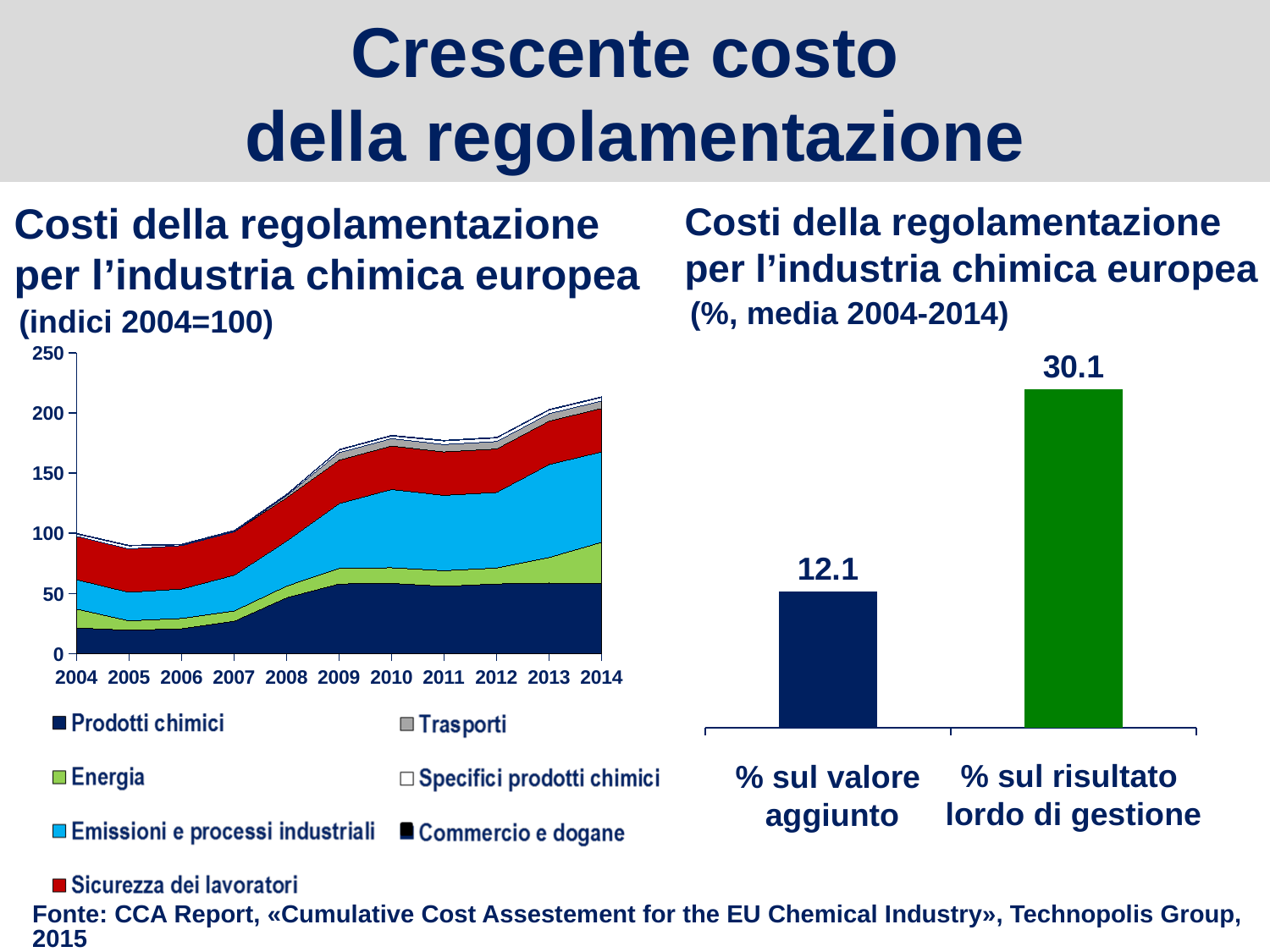
In the left chart (indici 2004=100), is the total value for 2005 greater or less than 100? less In the left chart (indici 2004=100), which series is shown in red? Sicurezza dei lavoratori In the left chart (indici 2004=100), is the total value for 2014 greater or less than 200? greater In the right chart (%, media 2004-2014), how many bars are shown? 2 In the left chart (indici 2004=100), how many years are shown on the x axis? 11 In the left chart (indici 2004=100), how many series does the legend list? 7 In the right chart (%, media 2004-2014), what is the difference between the two bars? 18.0 What kind of chart is the right chart (%, media 2004-2014)? Bar chart In the right chart (%, media 2004-2014), what is the value for '% sul valore aggiunto'? 12.1 In the right chart (%, media 2004-2014), what is the value for '% sul risultato lordo di gestione'? 30.1 In the left chart (indici 2004=100), do the total costs rise or fall between 2004 and 2014? Rise In the right chart (%, media 2004-2014), which category has the higher value? % sul risultato lordo di gestione